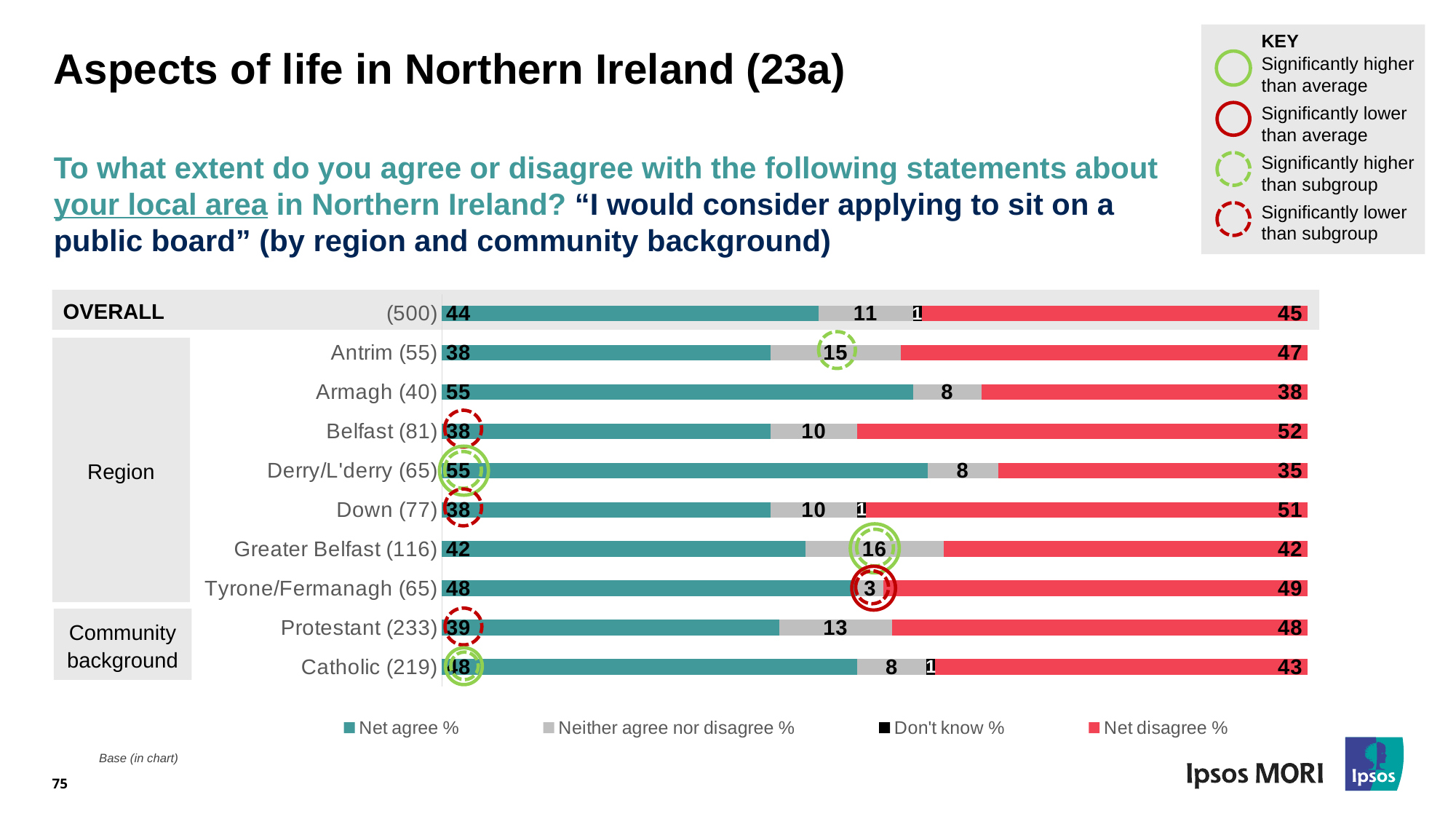
How many series does the legend list? 4 What kind of chart is shown on the slide? Stacked bar chart What is the Neither agree nor disagree % for Greater Belfast (116)? 16 Which category has the lowest Net disagree %? Derry/L'derry (65) What is the Net agree % for Armagh (40)? 55 What is the Net disagree % for Belfast (81)? 52 What is the difference in Net agree % between Catholic (219) and Protestant (233)? 9 How many categories (rows) are plotted in the chart? 10 Which category has the lowest Neither agree nor disagree %? Tyrone/Fermanagh (65) Which category has the highest Net disagree %? Belfast (81) What is the Net agree % for the OVERALL (500) row? 44 Which has a higher Net agree %, Armagh (40) or Antrim (55)? Armagh (40)